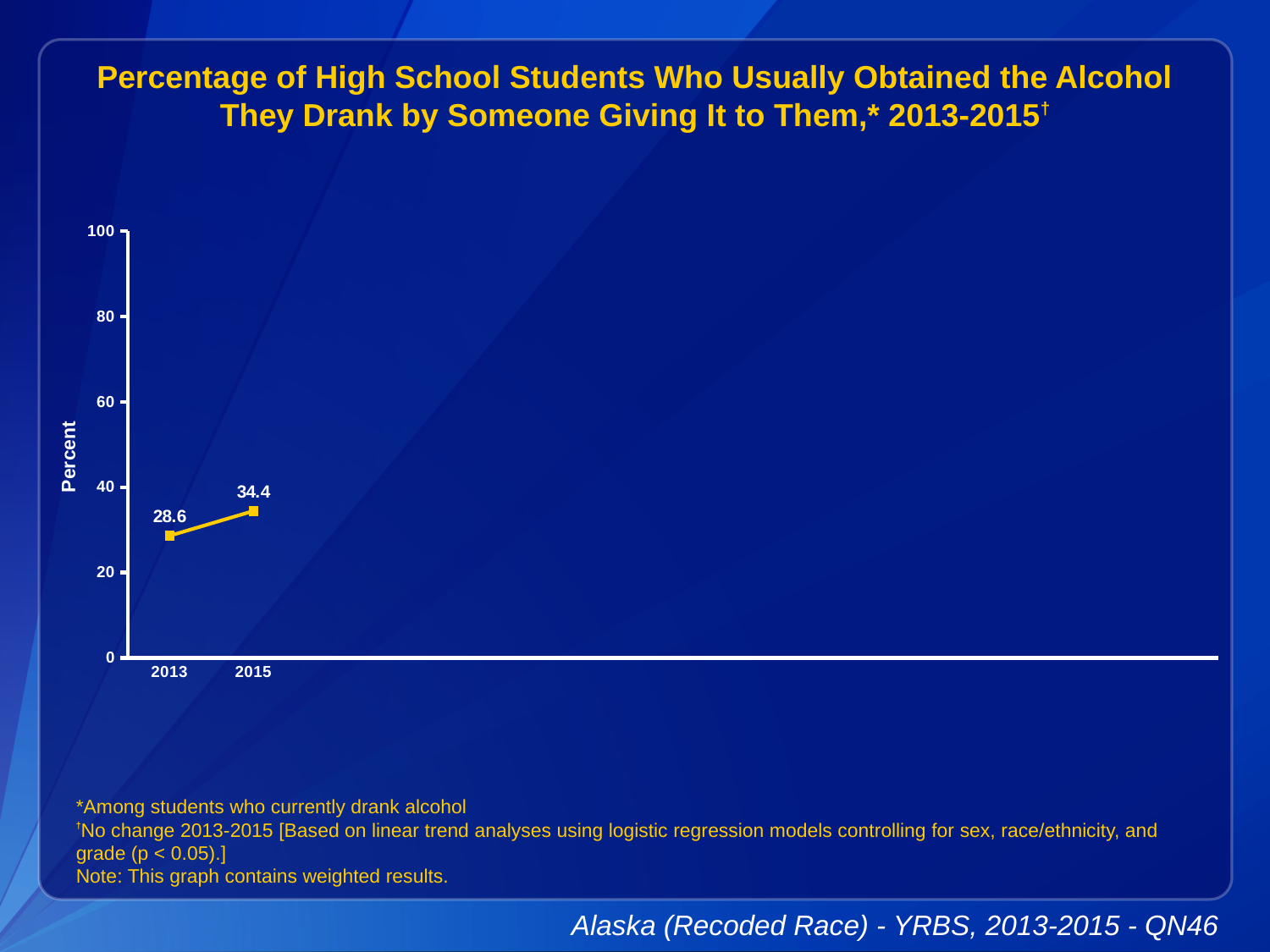
What is the maximum value shown on the y axis? 100 How many data points are plotted on the chart? 2 What is the label on the y axis? Percent What is the value for 2013? 28.6 What is the value for 2015? 34.4 Do the values rise or fall from 2013 to 2015? rise Which year has the higher value? 2015 Is the value for 2015 greater or less than 40? less What kind of chart is shown on the slide? line chart Is the value for 2013 greater or less than 20? greater Which year has the lower value? 2013 What is the difference between the 2015 and 2013 values? 5.8